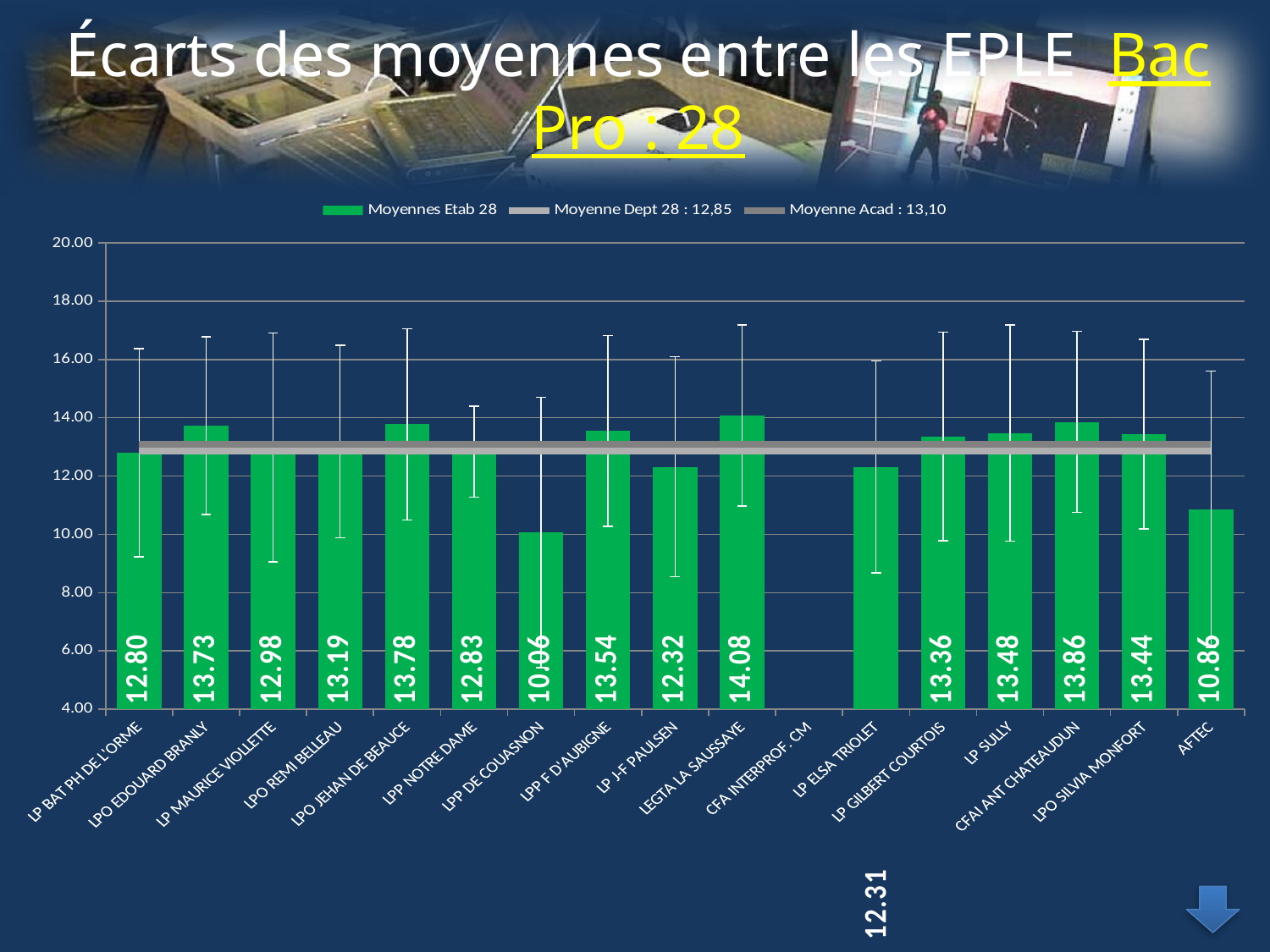
What is the average value shown for LPP NOTRE DAME? 12.83 Which establishment has the lowest average (Moyennes Etab 28)? LPP DE COUASNON How many series does the legend list? 3 What is the average value shown for LPO EDOUARD BRANLY? 13.73 What is the difference between the values for LPO EDOUARD BRANLY and LP BAT PH DE L'ORME? 0.93 What kind of chart is shown on the slide? bar chart Which has the larger value, LPO JEHAN DE BEAUCE or LP SULLY? LPO JEHAN DE BEAUCE What is the difference between the values for LEGTA LA SAUSSAYE and LPP DE COUASNON? 4.02 Which establishment has the highest average (Moyennes Etab 28)? LEGTA LA SAUSSAYE What is the average value shown for AFTEC? 10.86 According to the legend, what is the value of Moyenne Dept 28? 12,85 How many establishment labels are listed along the x axis? 17